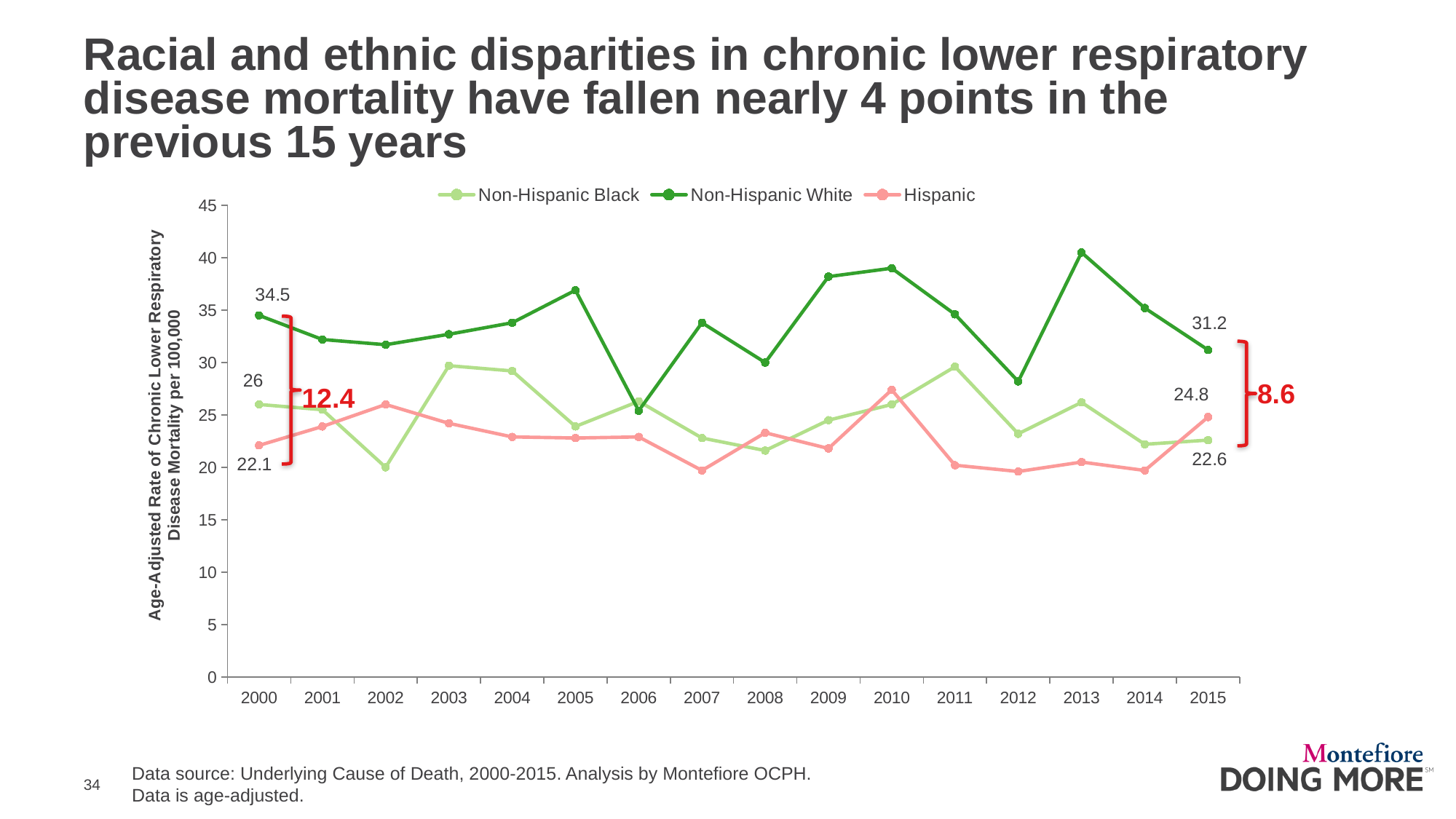
What kind of chart is shown on the slide? Line chart Which series has the highest value in 2015? Non-Hispanic White What is the value for Non-Hispanic Black in 2000? 26 How many years are shown on the x axis? 16 In 2000, which is larger: the Non-Hispanic Black value or the Hispanic value? Non-Hispanic Black Is the value for Non-Hispanic White in 2013 greater or less than 40? greater How many series does the legend list? 3 What is the value for Non-Hispanic Black in 2015? 22.6 What is the difference between the Non-Hispanic White and Hispanic values in 2000? 12.4 What is the value for Non-Hispanic White in 2000? 34.5 What is the difference between the Non-Hispanic White and Non-Hispanic Black values in 2015? 8.6 What is the value for Hispanic in 2015? 24.8